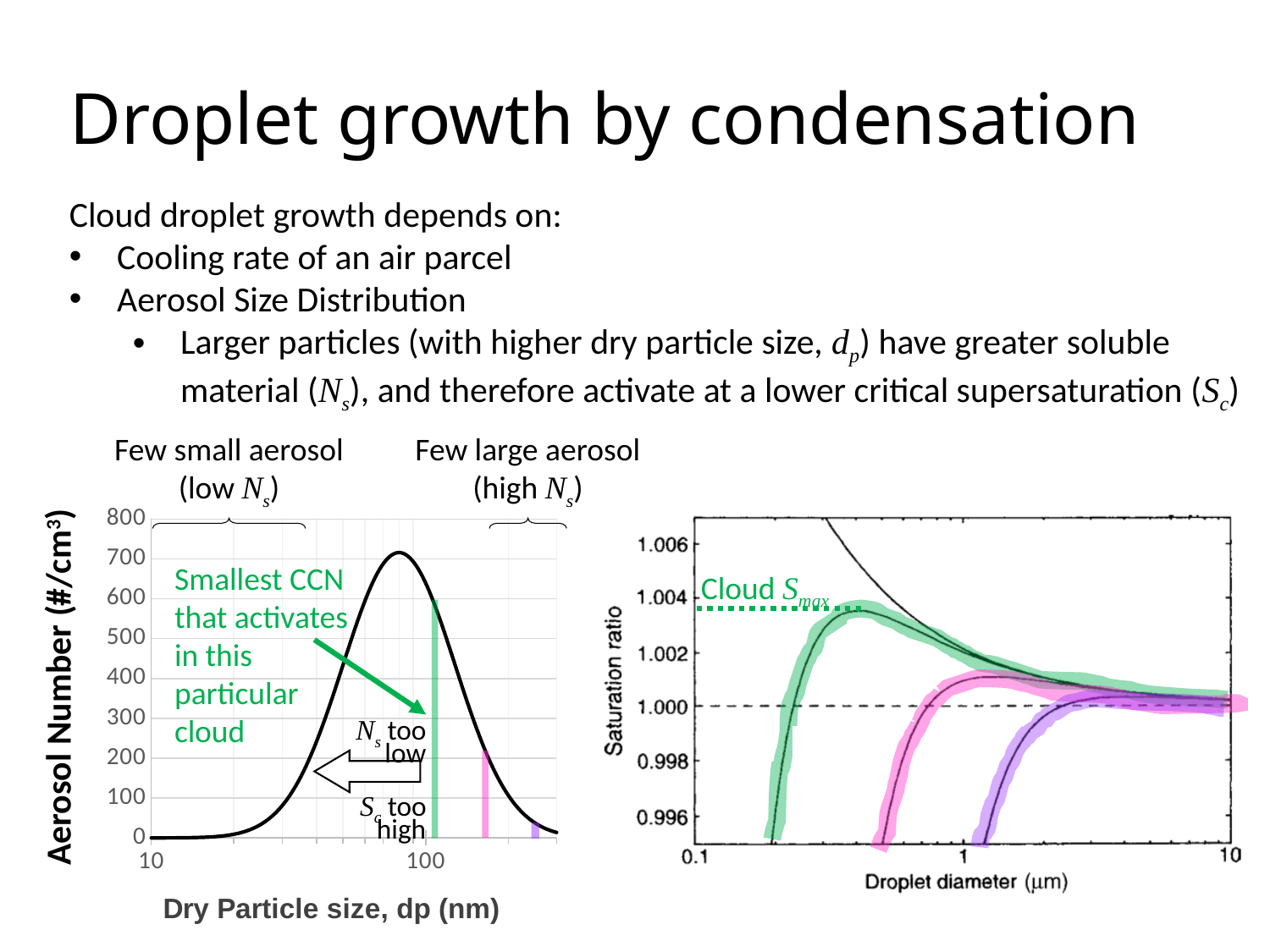
On the left chart, does the black curve rise or fall as dry particle size increases beyond 100 nm? fall On the left chart, how many coloured vertical bars are drawn on the curve? 3 On the left chart, is the height of the purple bar greater or less than 100? less On the right chart, is the peak of the pink curve greater or less than 1.002? less On the left chart, what is the highest value shown on the y axis? 800 On the right chart, how many coloured highlighted curves are shown? 3 On the left chart, what is the label of the y axis? Aerosol Number (#/cm³) What kind of chart is the left chart showing aerosol number against dry particle size? line chart On the left chart, what is the label of the x axis? Dry Particle size, dp (nm) On the right chart, what is the label of the x axis? Droplet diameter (μm) On the left chart, is the peak of the black curve greater or less than 600? greater On the right chart, which coloured curve reaches the highest saturation ratio? green